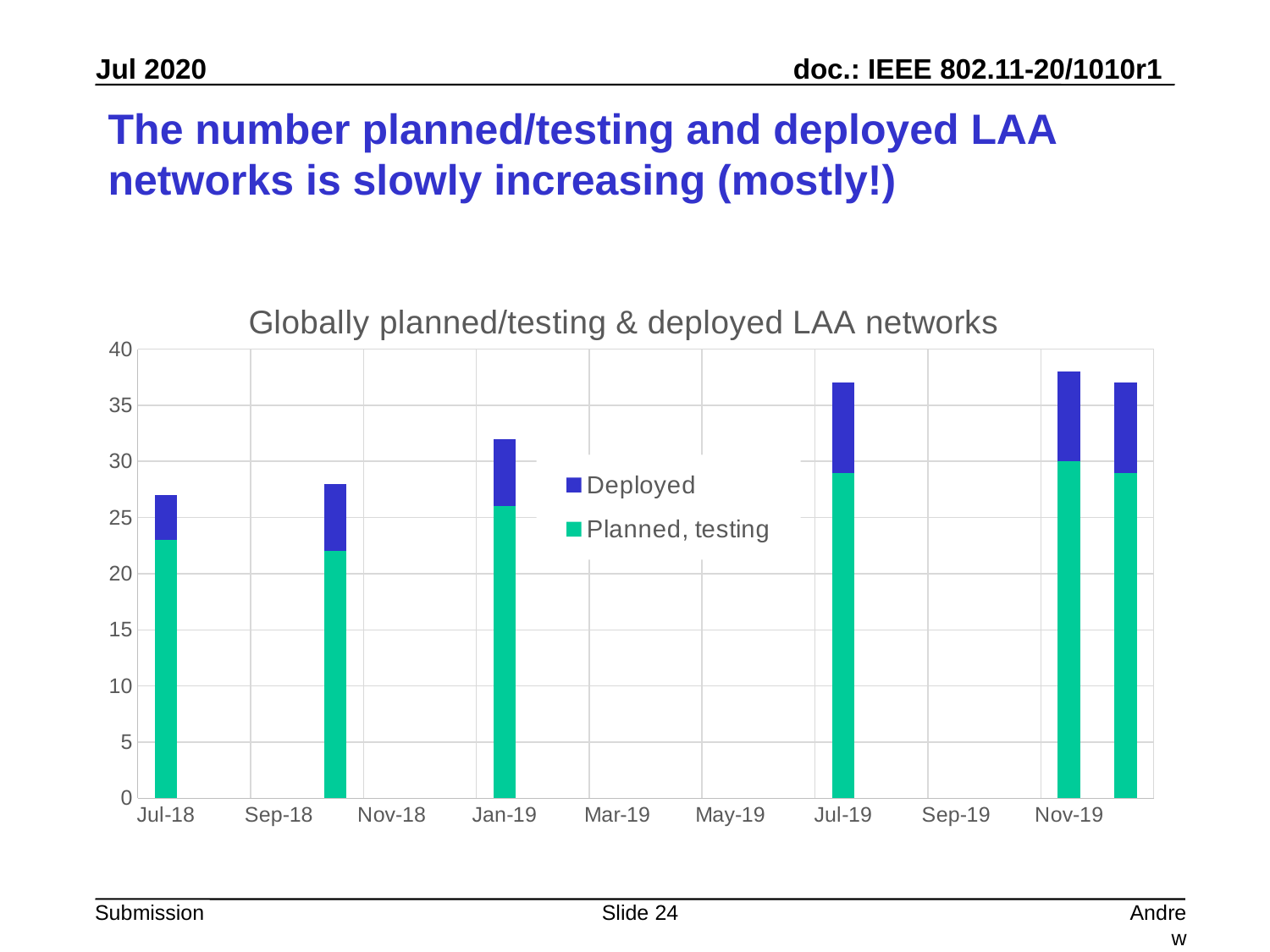
What are the two series named in the legend? Deployed; Planned, testing What is the title of the chart? Globally planned/testing & deployed LAA networks Do the total bar heights generally rise or fall from Jul-18 to Nov-19? rise Is the total height of the Jul-18 bar greater or less than 25? greater Is the total height of the Jan-19 bar greater or less than 30? greater What kind of chart is shown on the slide? bar chart How many series does the legend list? 2 How many bars are plotted in the chart? 6 Is the Planned, testing value for Jul-18 greater or less than 20? greater